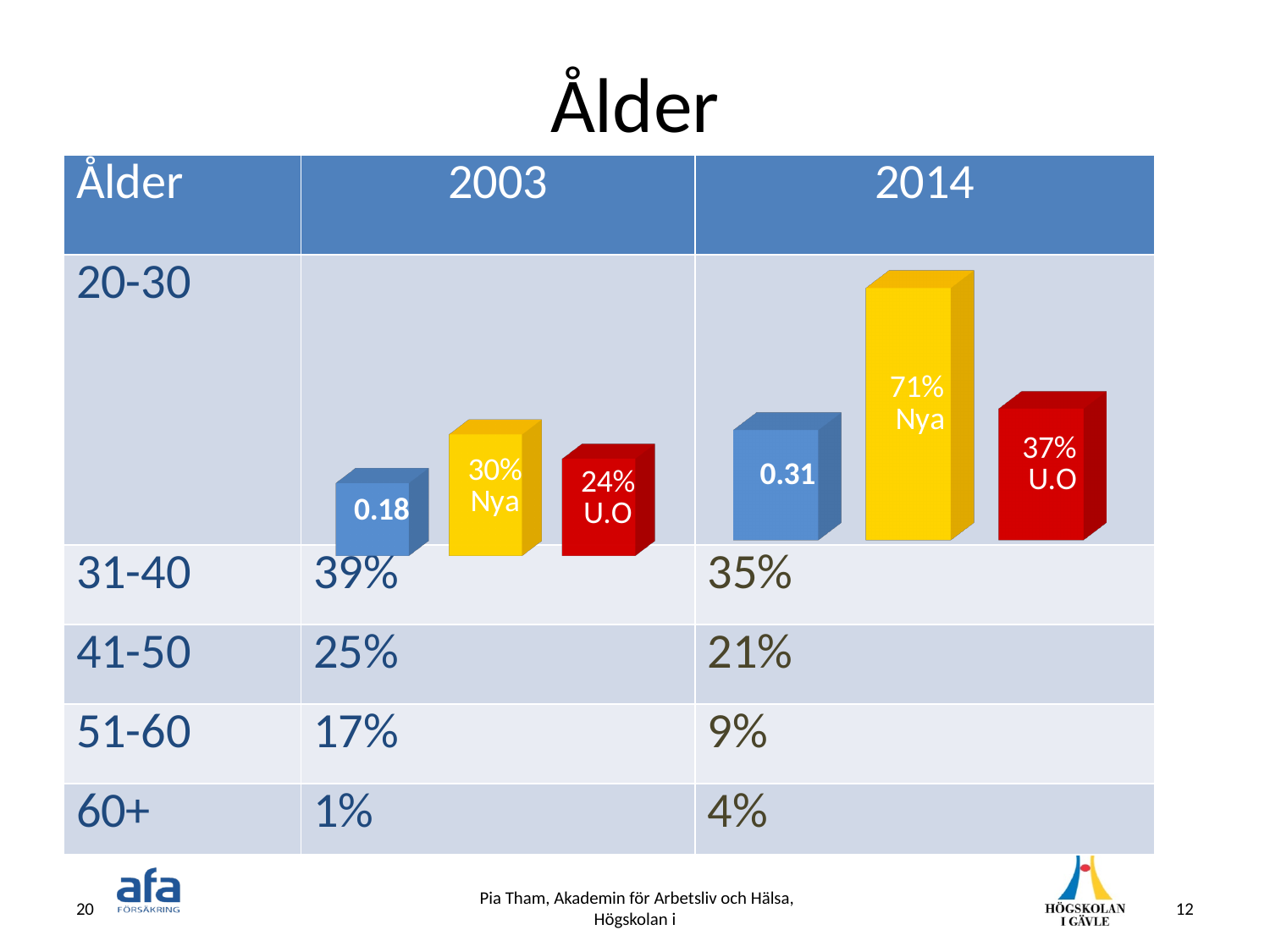
How many bars does the 2014 chart (right, 20-30 row) contain? 3 In the 2014 chart (right, 20-30 row), what is the difference between the Nya value and the U.O value? 34 percentage points In the 2003 chart (left, 20-30 row), what is the difference between the Nya value and the U.O value? 6 percentage points In the 2003 chart (left, 20-30 row), what value is printed on the blue bar? 0.18 What type of chart is shown in the 2003 cell of the 20-30 row? Bar chart In the 2003 chart (left, 20-30 row), what value is printed on the yellow "Nya" bar? 30% In the 2014 chart (right, 20-30 row), what colour is the bar labelled "Nya"? Yellow In the 2014 chart (right, 20-30 row), which bar is the tallest? Nya (71%) Is the Nya value larger in the 2003 chart or in the 2014 chart? 2014 In the 2014 chart (right, 20-30 row), what value is printed on the red "U.O" bar? 37% In the 2003 chart (left, 20-30 row), which bar is the shortest? The blue bar (0.18) In the 2014 chart (right, 20-30 row), what value is printed on the blue bar? 0.31